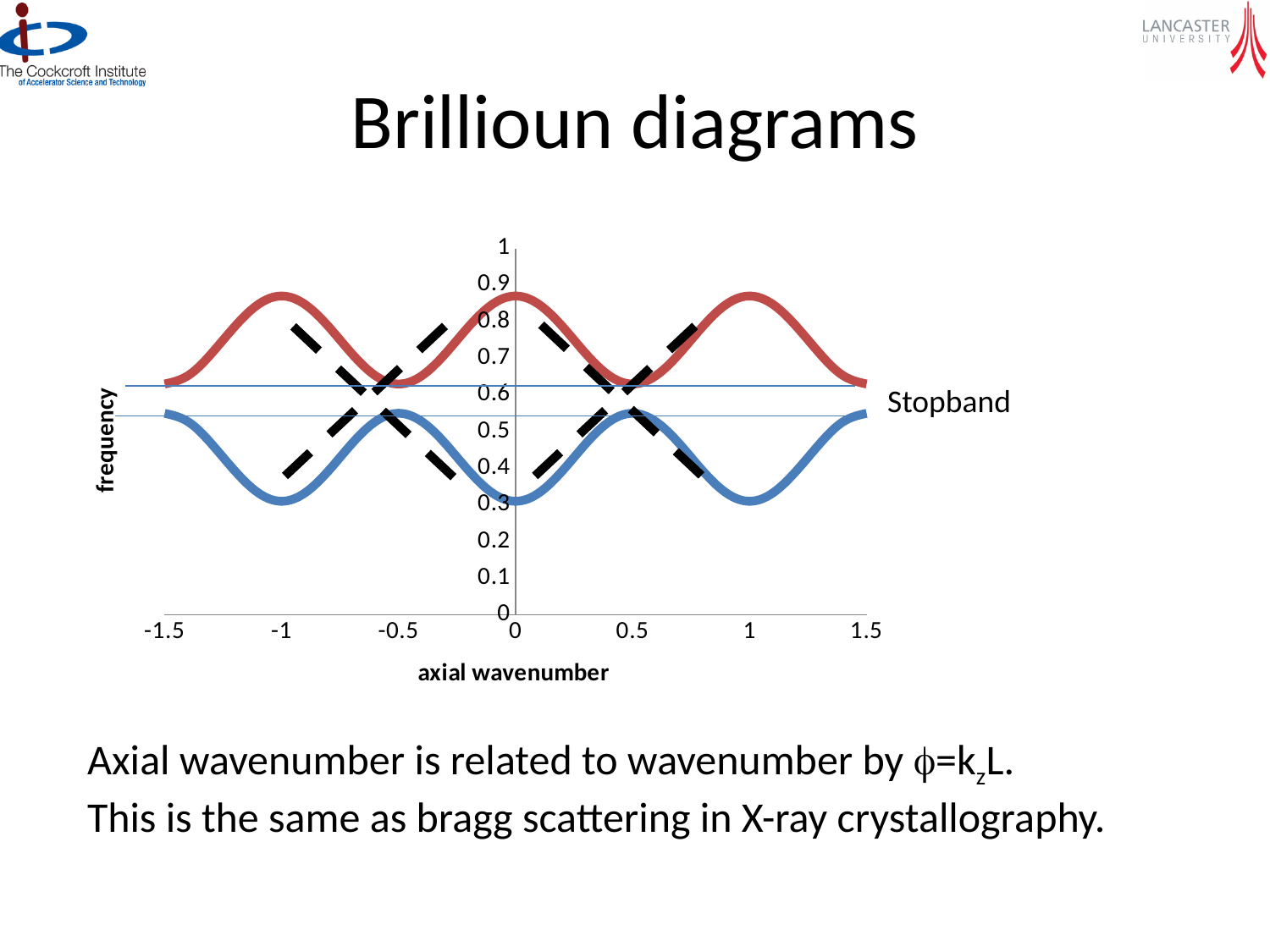
Does the red curve rise or fall as the axial wavenumber goes from 0 to 0.5? fall What is the label on the horizontal axis of the chart? axial wavenumber What is the label on the vertical axis of the chart? frequency Is the value of the blue curve at axial wavenumber 1 greater or less than 0.4? less Is the value of the blue curve at axial wavenumber 0 greater or less than 0.4? less At axial wavenumber 0, which curve has the higher frequency, the red curve or the blue curve? the red curve Is the value of the blue curve at axial wavenumber -0.5 greater or less than 0.6? less What kind of chart is shown on the slide? line chart How many tick labels are shown on the horizontal axis? 7